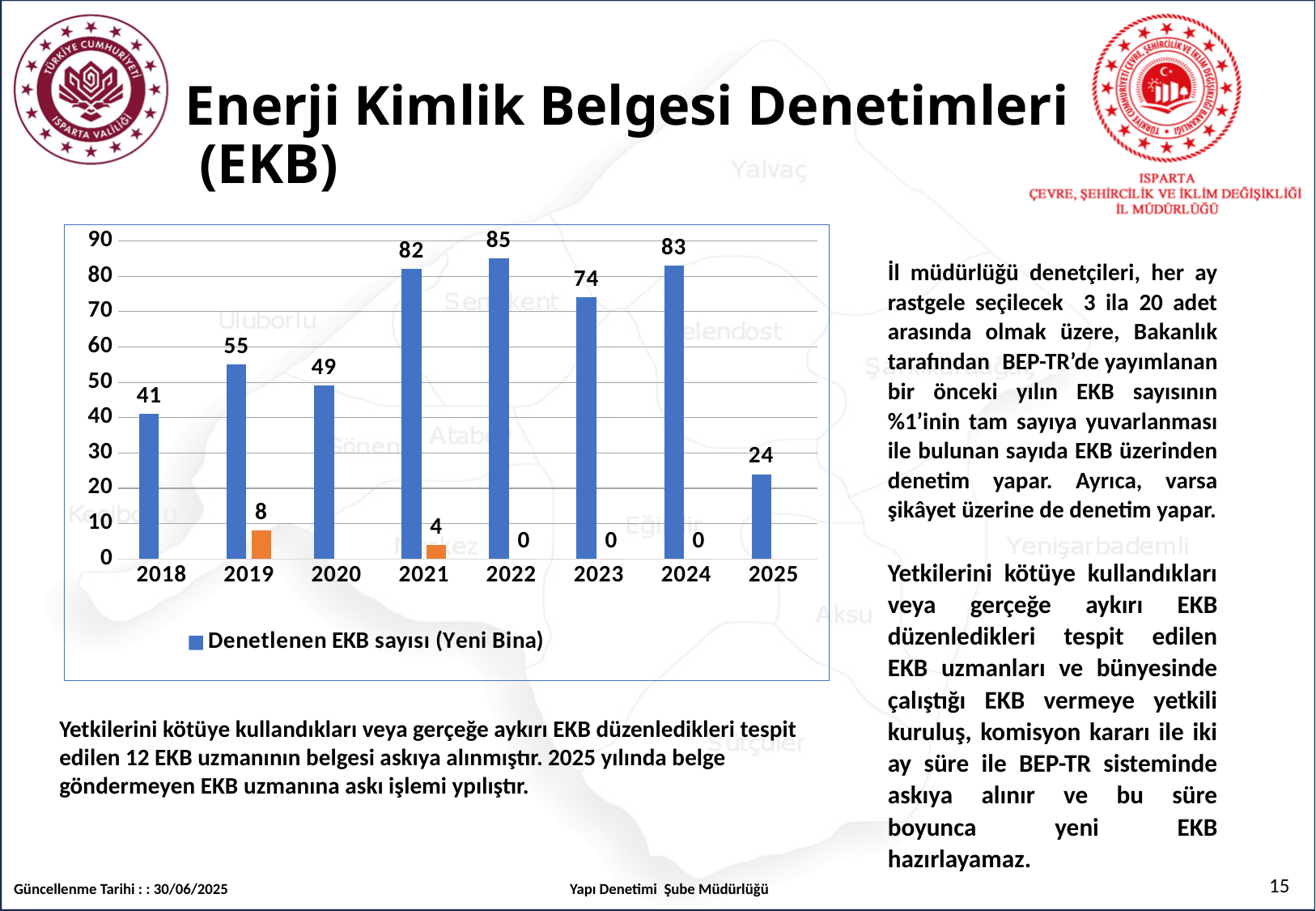
Is the value for Denetlenen EKB sayısı (Yeni Bina) in 2023 greater or less than 70? greater What kind of chart is shown on the slide? bar chart How many series does the chart legend list? 1 How many years are shown on the x axis of the chart? 8 Which year has a larger value for Denetlenen EKB sayısı (Yeni Bina), 2019 or 2020? 2019 What is the value of Denetlenen EKB sayısı (Yeni Bina) for 2022? 85 Which year has the highest value for Denetlenen EKB sayısı (Yeni Bina)? 2022 Does the value of Denetlenen EKB sayısı (Yeni Bina) rise or fall from 2018 to 2022? rise Which year has the lowest value for Denetlenen EKB sayısı (Yeni Bina)? 2025 What is the value of Denetlenen EKB sayısı (Yeni Bina) for 2018? 41 What is the difference between the Denetlenen EKB sayısı (Yeni Bina) values for 2021 and 2020? 33 What is the value of Denetlenen EKB sayısı (Yeni Bina) for 2025? 24